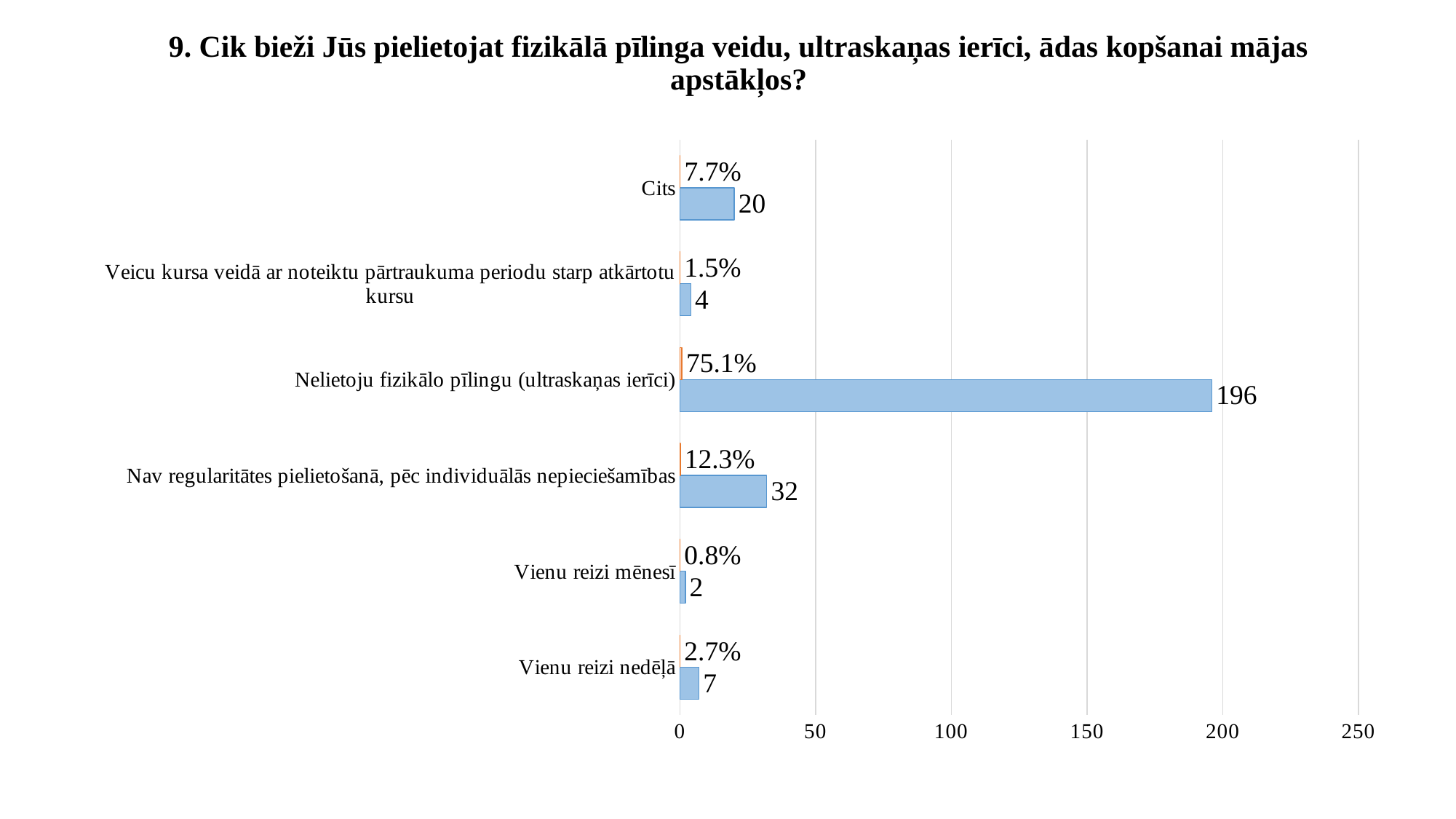
What kind of chart is shown on the slide? bar chart What percentage is shown for "Nav regularitātes pielietošanā, pēc individuālās nepieciešamības"? 12.3% What is the difference between the counts for "Nelietoju fizikālo pīlingu (ultraskaņas ierīci)" and "Nav regularitātes pielietošanā, pēc individuālās nepieciešamības"? 164 What percentage is shown for "Vienu reizi mēnesī"? 0.8% What is the count value for "Nelietoju fizikālo pīlingu (ultraskaņas ierīci)"? 196 What is the count value for "Cits"? 20 Is the count for "Nelietoju fizikālo pīlingu (ultraskaņas ierīci)" greater or less than 150? greater Which category has the lowest count? Vienu reizi mēnesī What is the count value for "Vienu reizi nedēļā"? 7 How many categories are shown on the chart? 6 Which category has the highest count? Nelietoju fizikālo pīlingu (ultraskaņas ierīci) Which has a larger count, "Cits" or "Vienu reizi nedēļā"? Cits